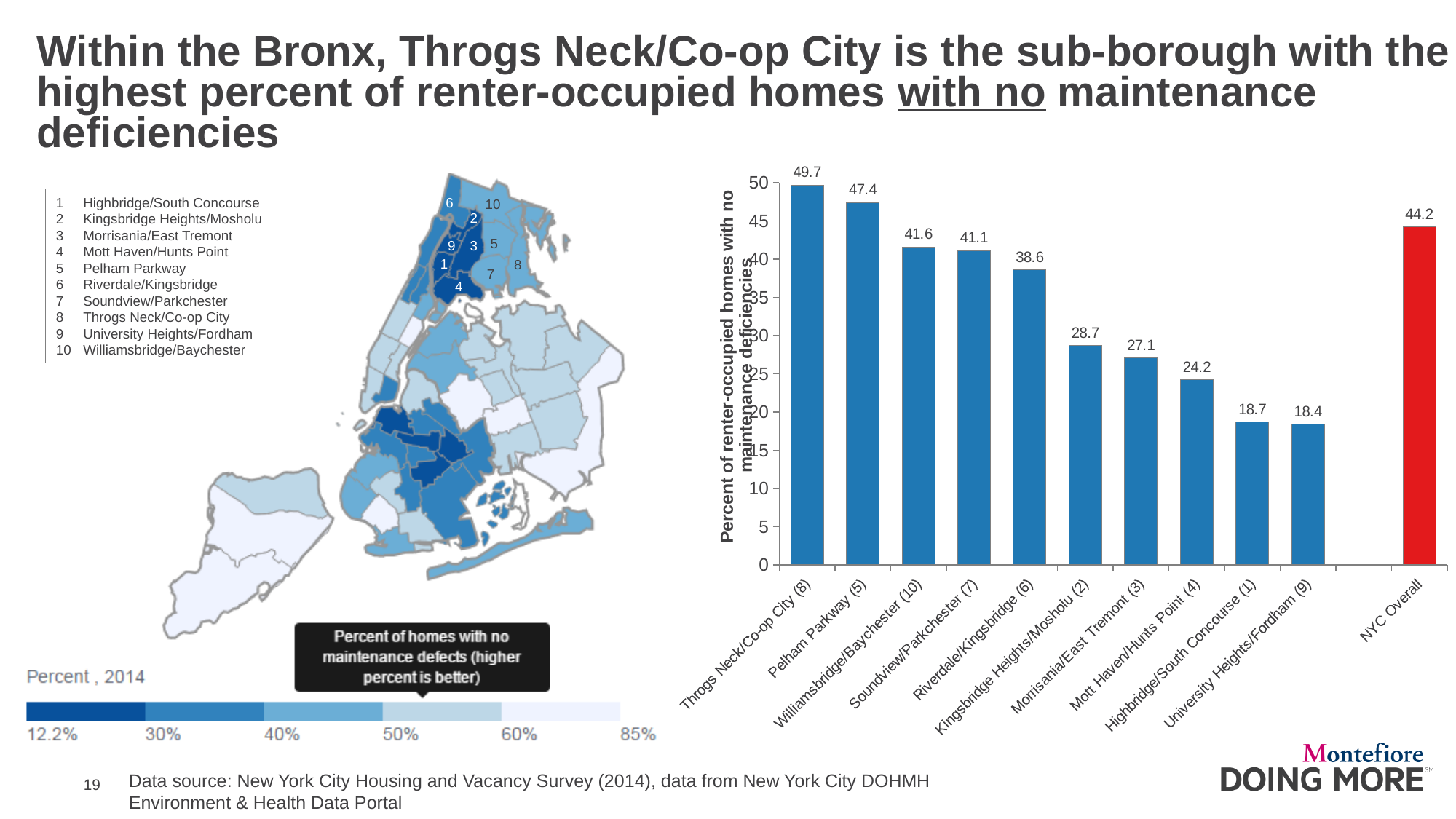
What kind of chart is shown on the right side of the slide? Bar chart In the bar chart, which category has the highest value? Throgs Neck/Co-op City (8) In the bar chart, which is larger: the value for Kingsbridge Heights/Mosholu (2) or Morrisania/East Tremont (3)? Kingsbridge Heights/Mosholu (2) In the bar chart, what is the difference between the values for Pelham Parkway (5) and Mott Haven/Hunts Point (4)? 23.2 In the bar chart, what is the difference between the values for Throgs Neck/Co-op City (8) and NYC Overall? 5.5 In the bar chart, what colour is the NYC Overall bar? Red In the bar chart, what is the value for Riverdale/Kingsbridge (6)? 38.6 In the bar chart, is the value for Soundview/Parkchester (7) greater or less than 40? greater In the bar chart, what is the value for NYC Overall? 44.2 How many bars are shown in the bar chart? 11 In the bar chart, what is the value for Throgs Neck/Co-op City (8)? 49.7 In the bar chart, which sub-borough has the lowest percent of renter-occupied homes with no maintenance deficiencies? University Heights/Fordham (9)